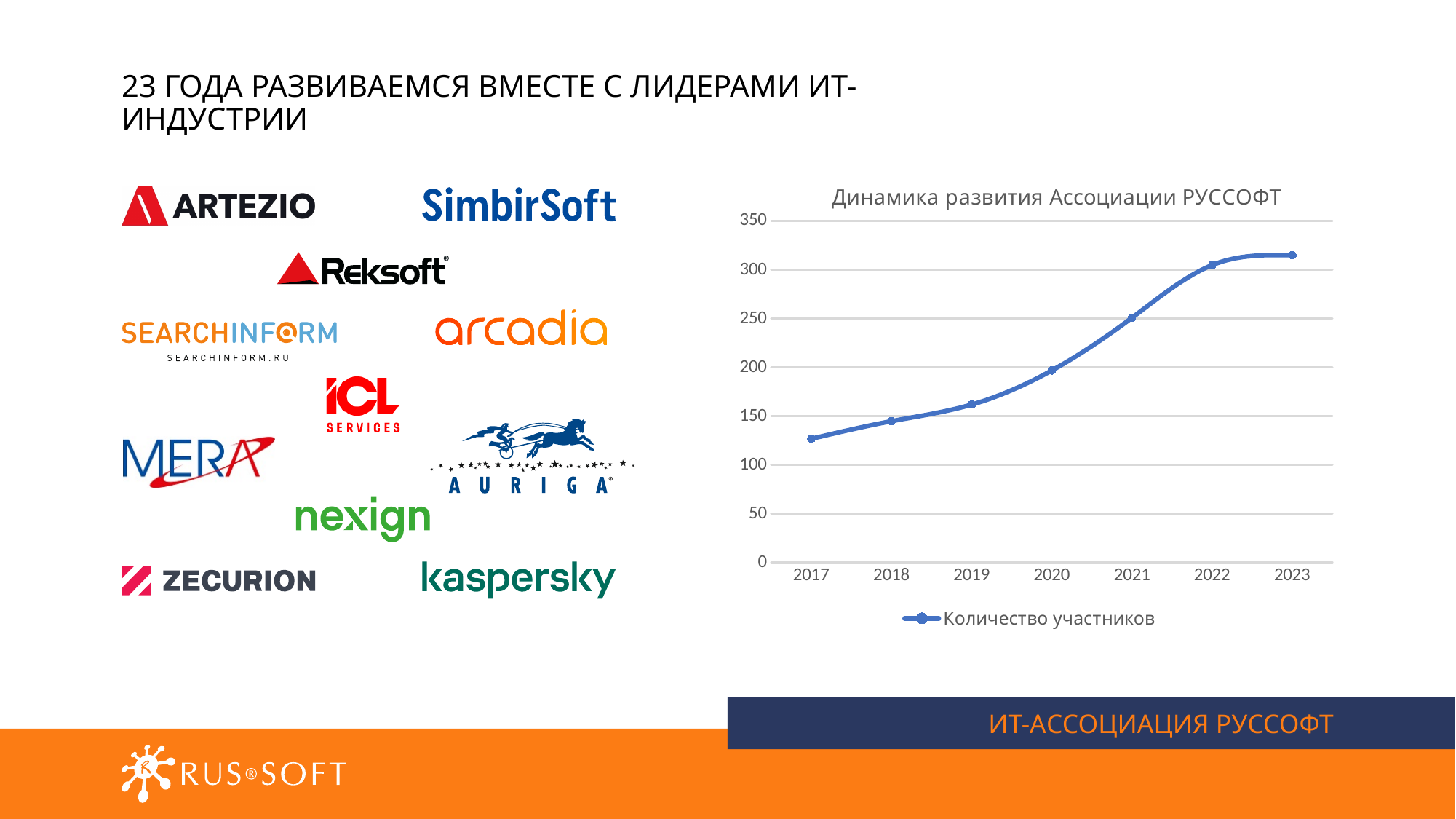
Which year has the highest number of participants? 2023 How many years are plotted on the x axis of the chart? 7 What is the title of the chart? Динамика развития Ассоциации РУССОФТ What series name does the chart legend list? Количество участников What kind of chart is shown on the slide? line chart Do the values rise or fall from 2017 to 2023? rise Which is larger, the value for 2019 or the value for 2021? 2021 How many series does the legend list? 1 Is the value for 2021 greater or less than 200? greater Which year has the lowest number of participants? 2017 Is the value for 2023 greater or less than 300? greater Is the value for 2017 greater or less than 150? less